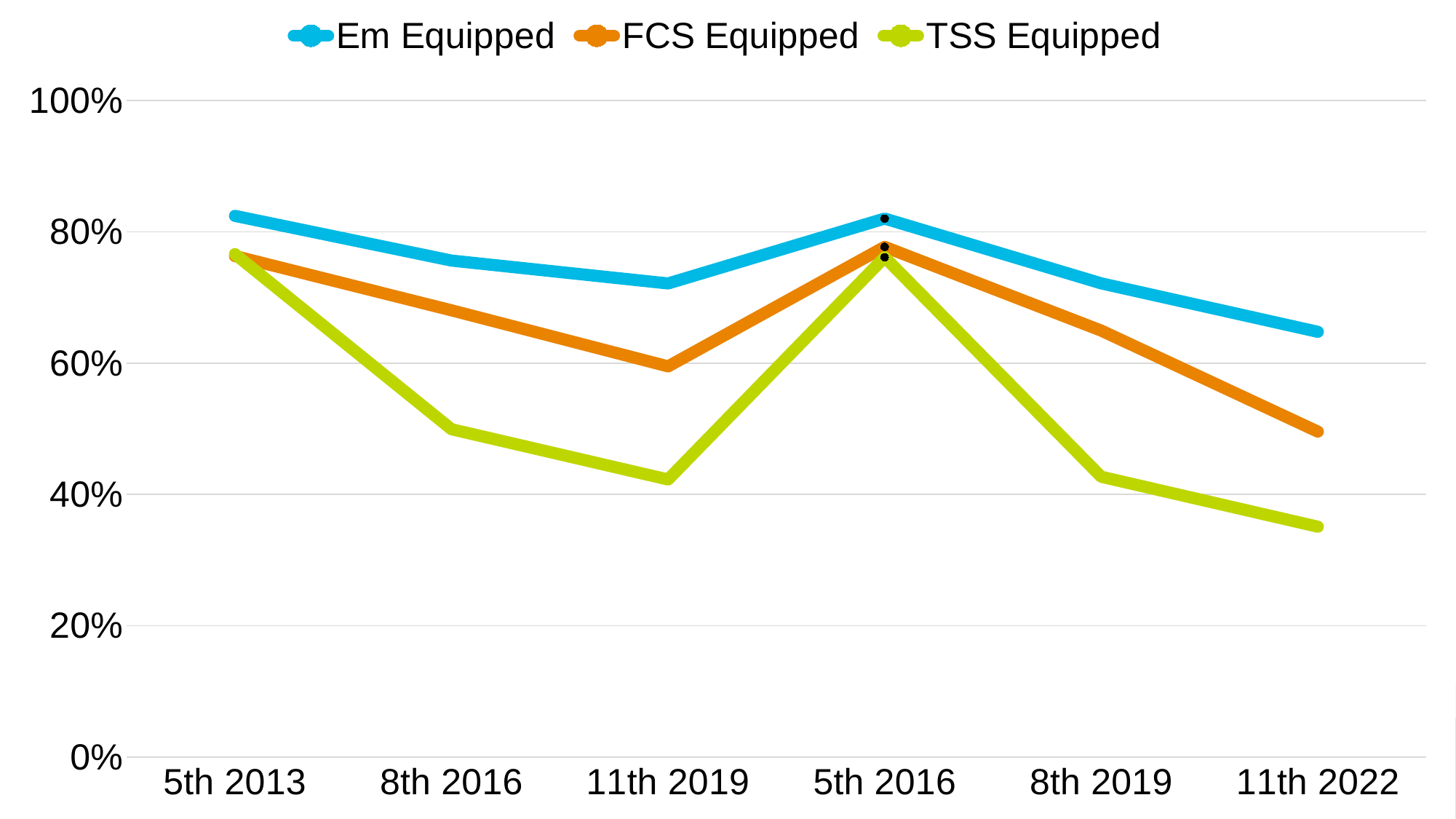
How many series does the legend list? 3 Which series has the highest value at 8th 2019? Em Equipped Which series has the lowest value at 11th 2022? TSS Equipped Is the value for Em Equipped at 5th 2013 greater or less than 80%? greater For TSS Equipped, does the value rise or fall from 5th 2016 to 11th 2022? fall Is the value for TSS Equipped at 8th 2016 greater or less than 60%? less At 11th 2019, which is larger: the value for FCS Equipped or the value for TSS Equipped? FCS Equipped How many categories are shown on the x axis? 6 Which series is drawn in orange? FCS Equipped What kind of chart is shown on the slide? line chart Is the value for TSS Equipped at 11th 2022 greater or less than 40%? less